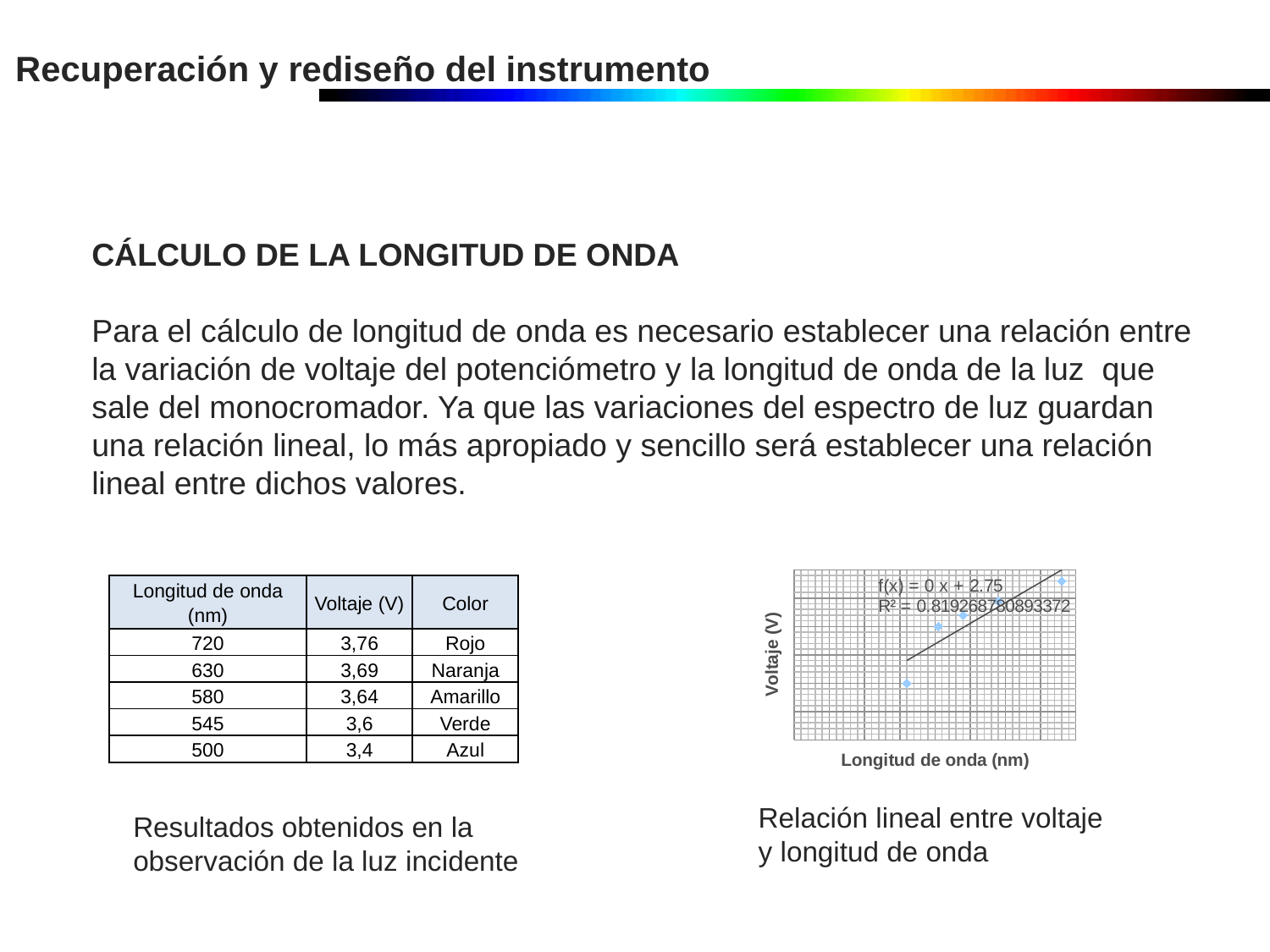
What R² value is printed on the chart on the right? 0.819268780893372 What is the title of the y axis of the chart on the right? Voltaje (V) In the chart on the right, do the plotted values rise or fall as the wavelength increases along the x axis? rise What is the title of the x axis of the chart on the right? Longitud de onda (nm) What is the intercept shown in the trendline equation printed on the chart on the right? 2.75 How many data points are plotted in the chart on the right? 5 What kind of chart is shown on the right of the slide? scatter chart